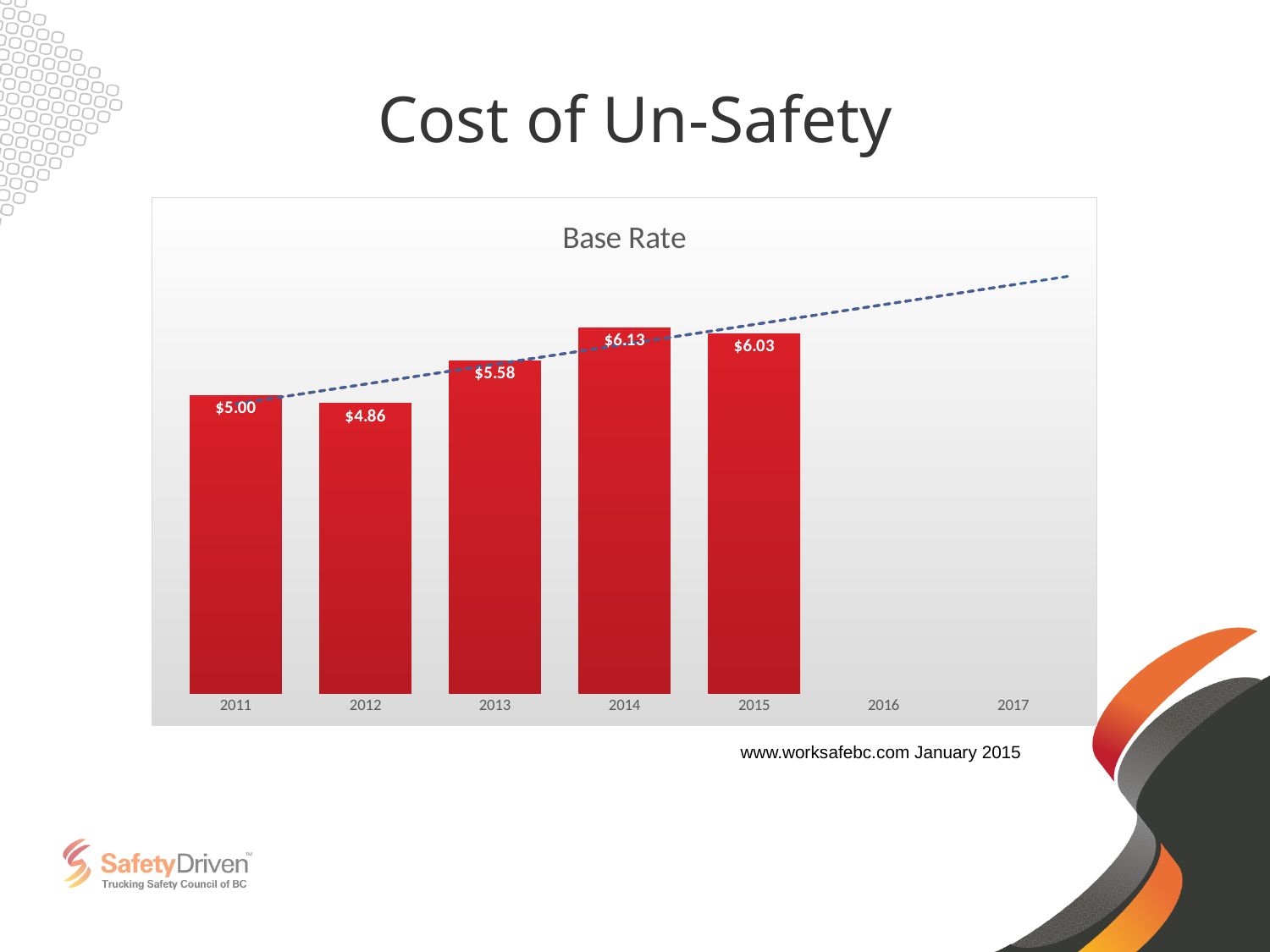
What is the base rate shown for 2013? $5.58 Which year has the highest base rate? 2014 What kind of chart is shown on the slide? Bar chart What is the base rate shown for 2015? $6.03 Which year has a larger base rate, 2012 or 2015? 2015 What is the title of the chart? Base Rate Does the dashed trend line rise or fall from 2011 to 2017? Rises What is the difference between the base rate in 2013 and the base rate in 2012? $0.72 What is the base rate shown for 2011? $5.00 What is the difference between the base rate in 2014 and the base rate in 2011? $1.13 How many bars are plotted in the chart? 5 Which year has the lowest base rate? 2012